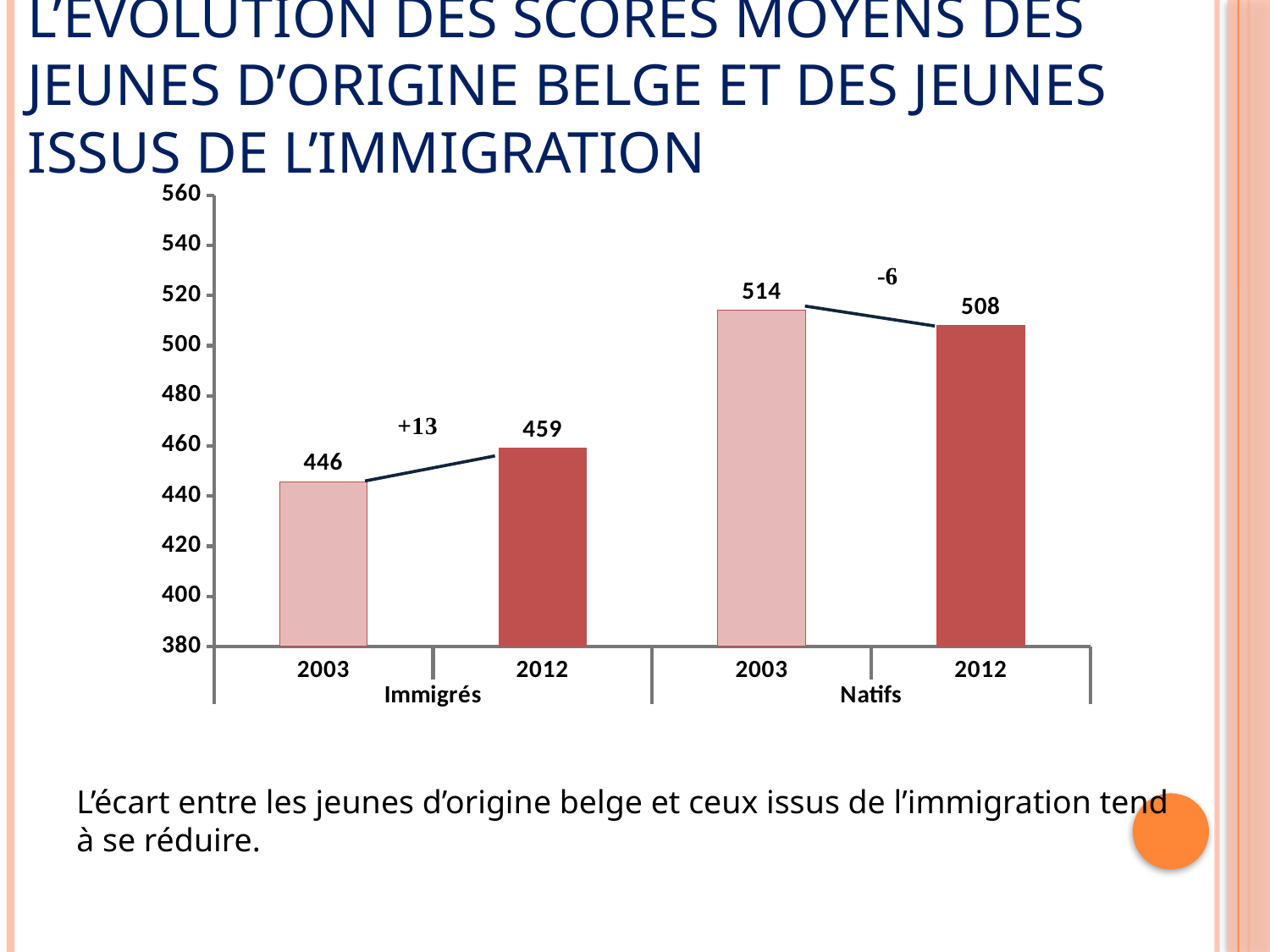
What is the difference between the Natifs score in 2012 and the Immigrés score in 2012? 49 What kind of chart is shown on the slide? Bar chart What is the average score for Immigrés in 2012? 459 Which bar shows the lowest score? Immigrés 2003 Which bar shows the highest score? Natifs 2003 What is the average score for Natifs in 2003? 514 By how much did the Immigrés score change between 2003 and 2012? +13 How many bars are plotted in the chart? 4 What is the average score for Immigrés in 2003? 446 Do the Natifs scores rise or fall from 2003 to 2012? Fall What is the average score for Natifs in 2012? 508 Which is larger, the Natifs score in 2003 or the Natifs score in 2012? Natifs 2003